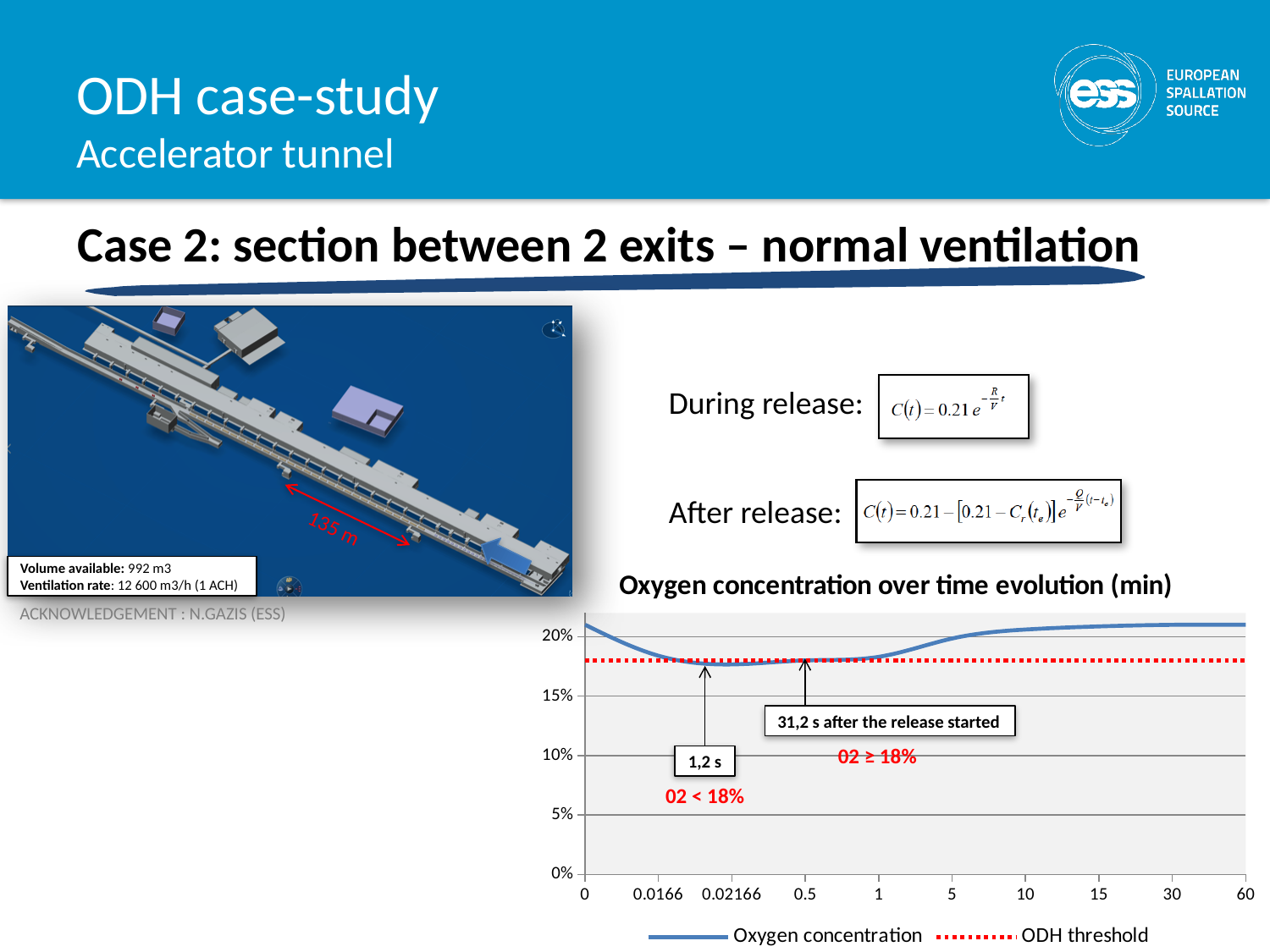
Is the oxygen concentration at time 0 greater or less than 20%? greater Does the oxygen concentration rise or fall between 1 min and 60 min? rise What is the title of the chart? Oxygen concentration over time evolution (min) Does the oxygen concentration rise or fall between 0 and 0.02166 min? fall Is the oxygen concentration at 0.02166 min greater or less than 20%? less Is the ODH threshold line greater or less than 15%? greater What are the two series named in the chart legend? Oxygen concentration and ODH threshold How many tick labels are shown on the x axis of the chart? 10 What kind of chart is shown on the slide? line chart How many series does the legend of the chart list? 2 At which x-axis tick is the oxygen concentration lowest? 0.02166